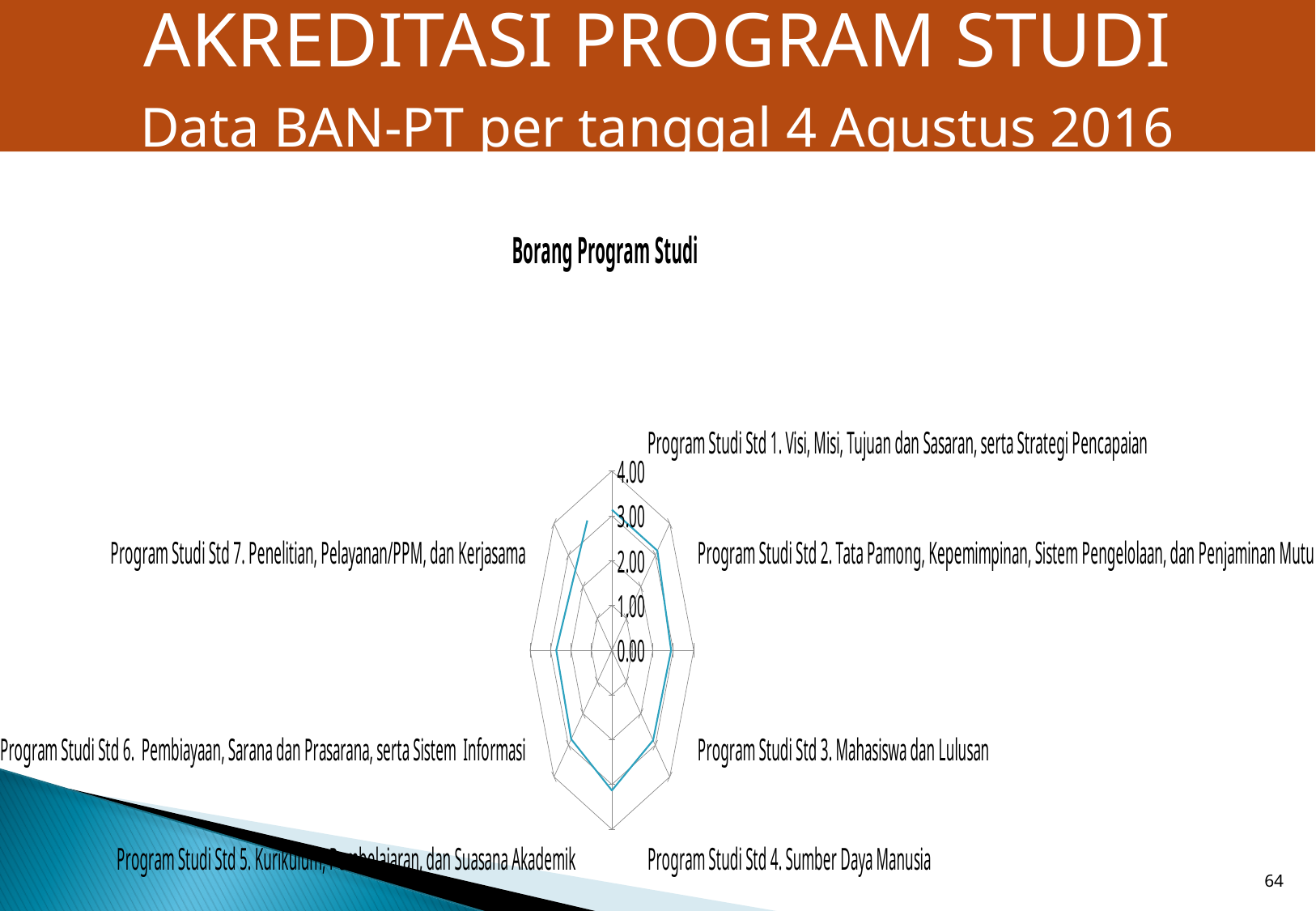
Is the value for Program Studi Std 5. Kurikulum, Pembelajaran, dan Suasana Akademik greater or less than 4.00? less Is the value for Program Studi Std 4. Sumber Daya Manusia greater or less than 2.00? greater How many categories (standards) are plotted on the radar chart? 7 What kind of chart is shown on the slide? Radar chart Is the value for Program Studi Std 3. Mahasiswa dan Lulusan greater or less than 4.00? less What is the title of the chart? Borang Program Studi What is the highest value shown on the chart's axis scale? 4.00